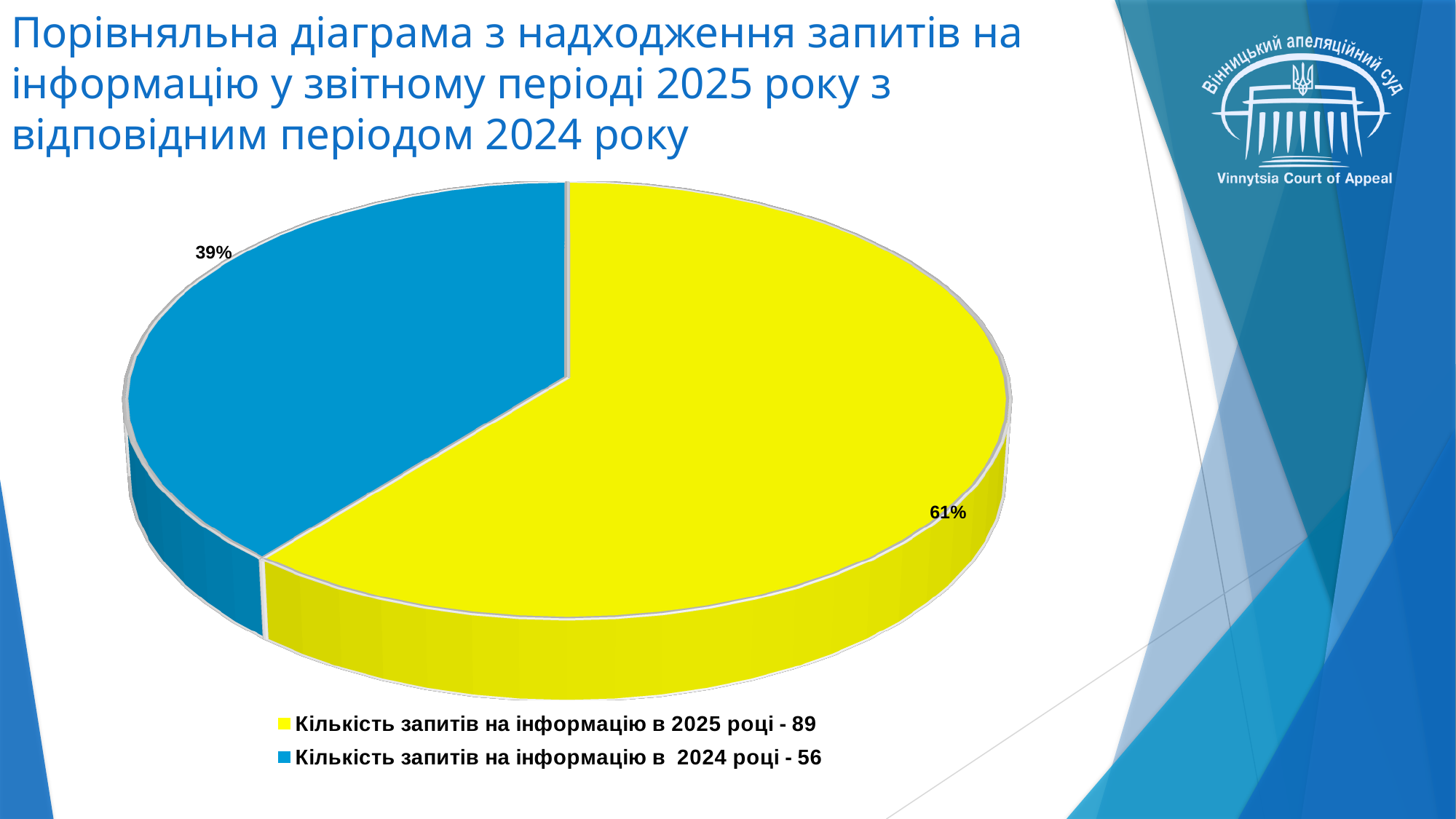
According to the legend, how many requests for information were received in 2025? 89 Which year has the smaller slice of the pie? 2024 According to the legend, how many requests for information were received in 2024? 56 How many slices does the pie chart have? 2 Which year has the larger slice of the pie, 2025 or 2024? 2025 What is the difference between the number of requests in 2025 and in 2024? 33 What share of the pie is the slice for requests for information in 2024? 39% What is the difference in percentage points between the 2025 slice and the 2024 slice? 22 What kind of chart is shown on the slide? pie chart How many entries does the legend list? 2 What share of the pie is the slice for requests for information in 2025? 61% What colour is the slice representing requests for information in 2024? blue